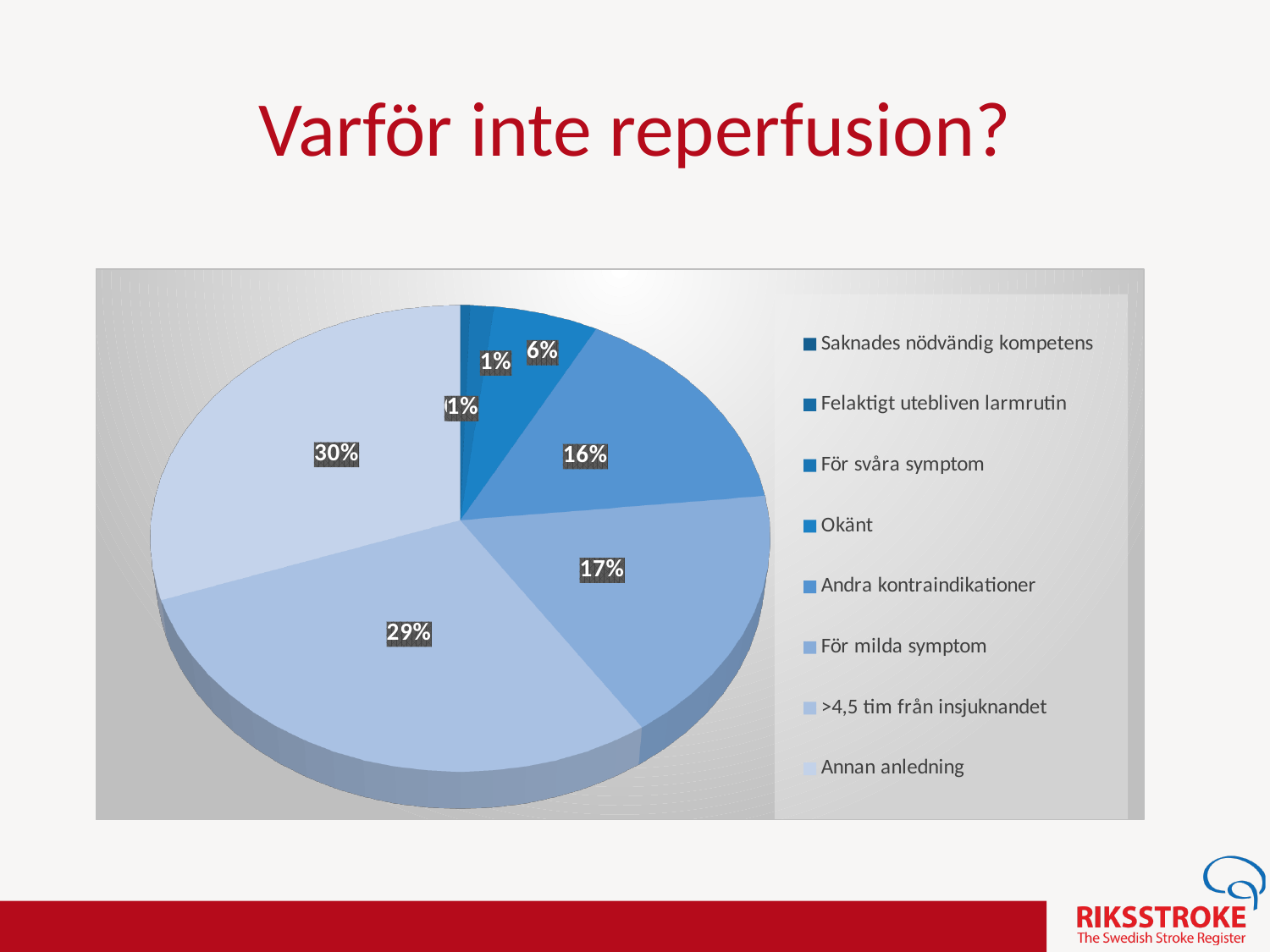
Which is larger, the share for 'Andra kontraindikationer' or the share for 'För svåra symptom'? Andra kontraindikationer What is the difference between the shares for 'För milda symptom' and 'Okänt'? 11% What share of the pie is labelled for 'För svåra symptom'? 1% What share of the pie is labelled for '>4,5 tim från insjuknandet'? 29% What share of the pie is labelled for 'Okänt'? 6% How many entries does the legend of the pie chart list? 8 Which category has the largest slice of the pie? Annan anledning What is the title of the slide containing the pie chart? Varför inte reperfusion? What type of chart is shown on the slide? pie chart What is the combined share of '>4,5 tim från insjuknandet' and 'För milda symptom'? 46%